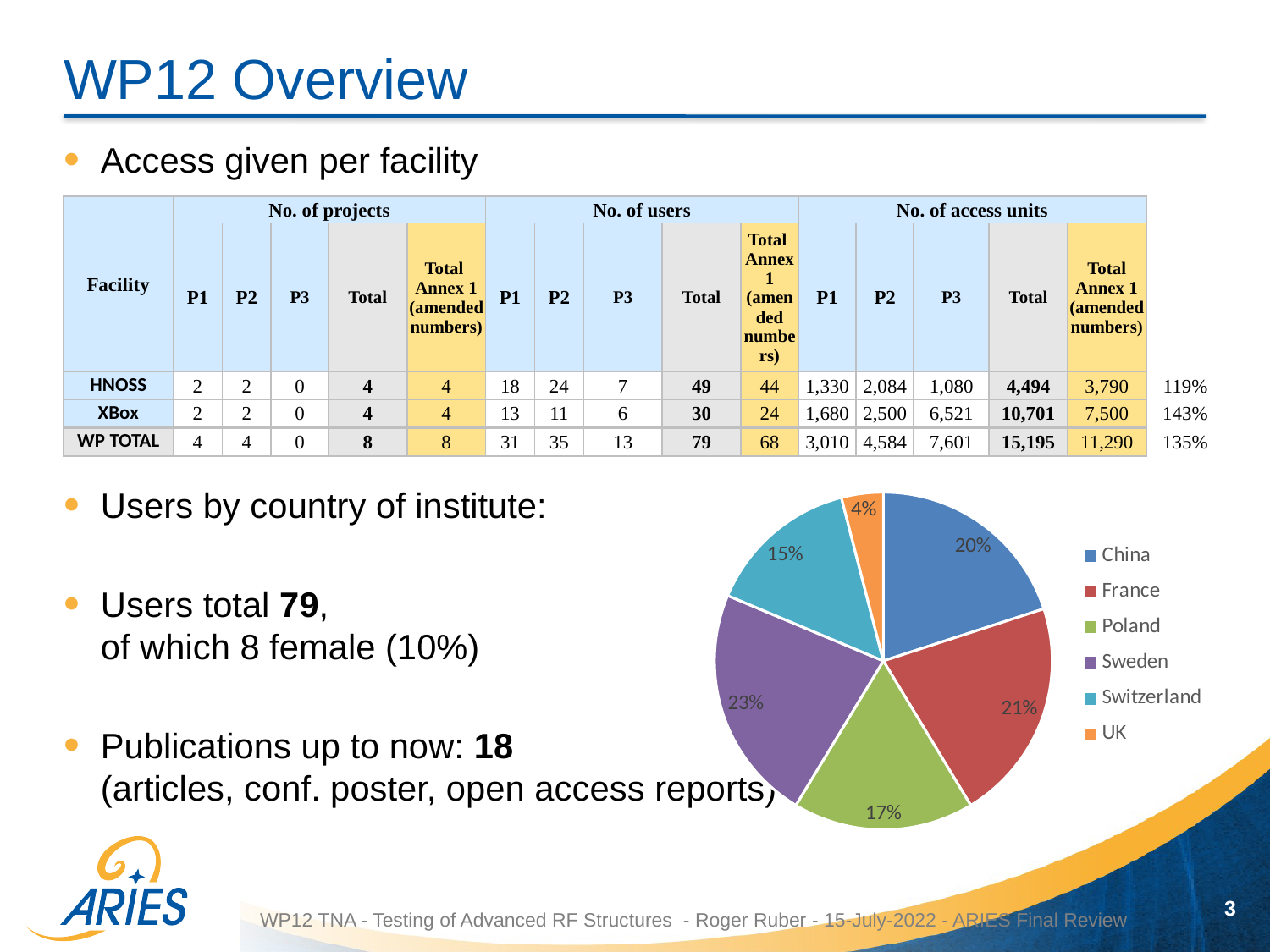
What share of users comes from Poland in the pie chart? 17% What type of chart is shown on the slide? pie chart What share of users comes from Sweden in the pie chart? 23% How many entries does the pie chart legend list? 6 Which slice is larger, France or Poland? France Which country has the largest share in the pie chart? Sweden What is the difference in percentage points between the Sweden and Switzerland slices? 8 How many countries are shown in the pie chart? 6 What colour is the Switzerland slice in the pie chart? teal (light blue) What share of users comes from the UK in the pie chart? 4% Which country has the smallest share in the pie chart? UK What share of users comes from China in the pie chart? 20%